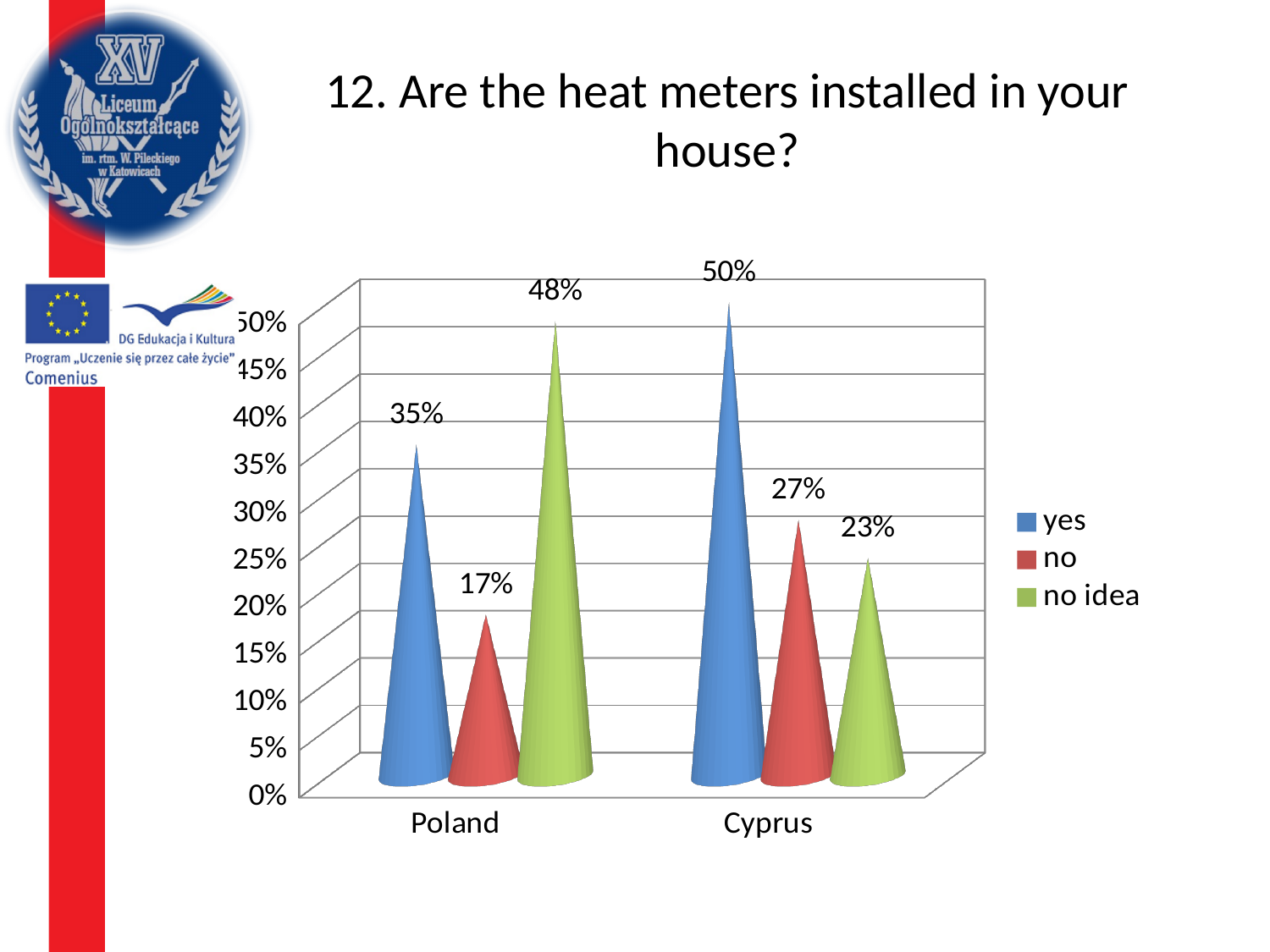
Which answer has the lowest percentage for Cyprus? no idea How many countries are shown on the x axis? 2 What kind of chart is shown on the slide? bar chart What is the difference between the "yes" percentages for Cyprus and Poland? 15% What percentage of respondents in Poland answered "yes"? 35% Which colour represents the "no" series in the legend? red Which answer has the highest percentage for Poland? no idea Which country has a higher "no" percentage, Poland or Cyprus? Cyprus How many series does the legend list? 3 What percentage of respondents in Poland answered "no"? 17% What percentage of respondents in Cyprus answered "no idea"? 23% What percentage of respondents in Cyprus answered "yes"? 50%